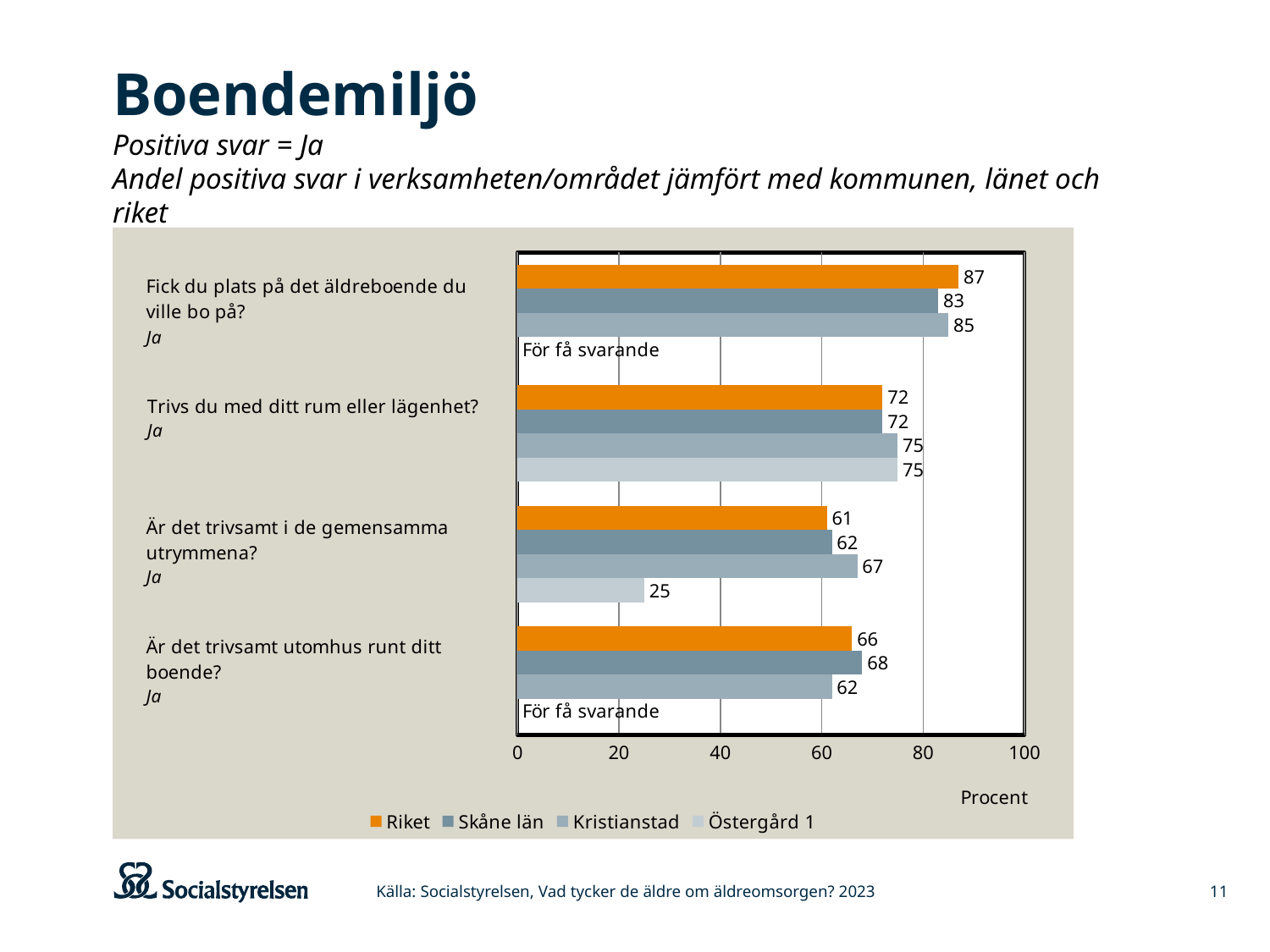
What is the value for Skåne län on "Är det trivsamt utomhus runt ditt boende?"? 68 What is the value for Riket on "Fick du plats på det äldreboende du ville bo på?"? 87 What is the difference between Kristianstad and Östergård 1 on "Är det trivsamt i de gemensamma utrymmena?"? 42 Which series has the highest value on "Fick du plats på det äldreboende du ville bo på?"? Riket On "Är det trivsamt utomhus runt ditt boende?", which is larger, Skåne län or Kristianstad? Skåne län How many series does the legend list? 4 Which series has the lowest value on "Är det trivsamt i de gemensamma utrymmena?"? Östergård 1 What is shown for Östergård 1 on "Fick du plats på det äldreboende du ville bo på?" instead of a value? För få svarande How many survey questions (categories) are shown on the chart? 4 What kind of chart is shown on the slide? Bar chart What is the value for Östergård 1 on "Är det trivsamt i de gemensamma utrymmena?"? 25 What is the value for Kristianstad on "Trivs du med ditt rum eller lägenhet?"? 75